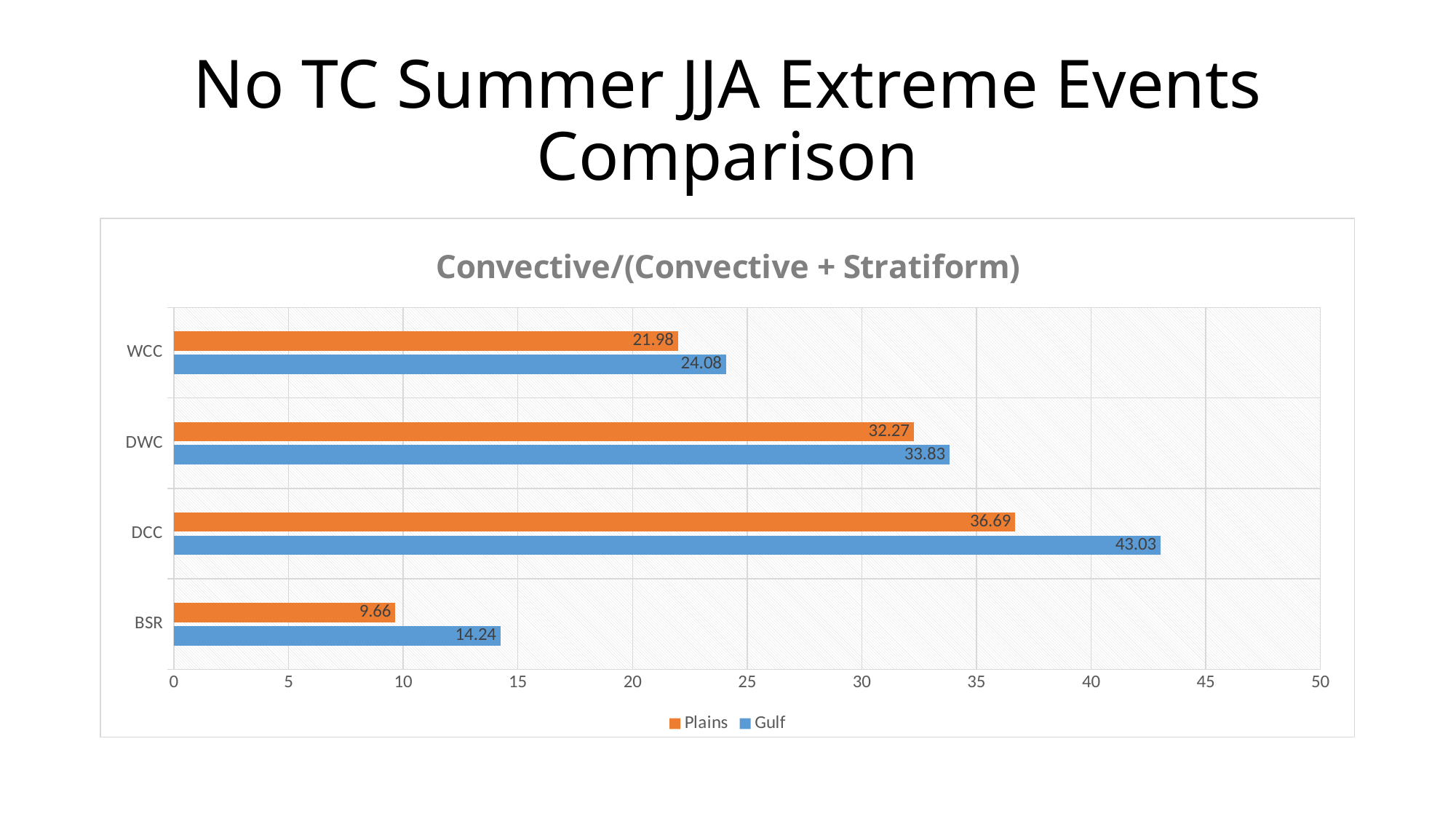
What is the title of the chart? Convective/(Convective + Stratiform) Which category has the highest Gulf value? DCC Which is larger for WCC, the Plains value or the Gulf value? Gulf What is the Gulf value for DCC? 43.03 How many series does the legend list? 2 What kind of chart is shown? Bar chart What is the Plains value for WCC? 21.98 What is the difference between the Gulf and Plains values for DCC? 6.34 Which category has the lowest Plains value? BSR What is the Plains value for BSR? 9.66 How many categories are shown on the y axis? 4 What is the Gulf value for DWC? 33.83